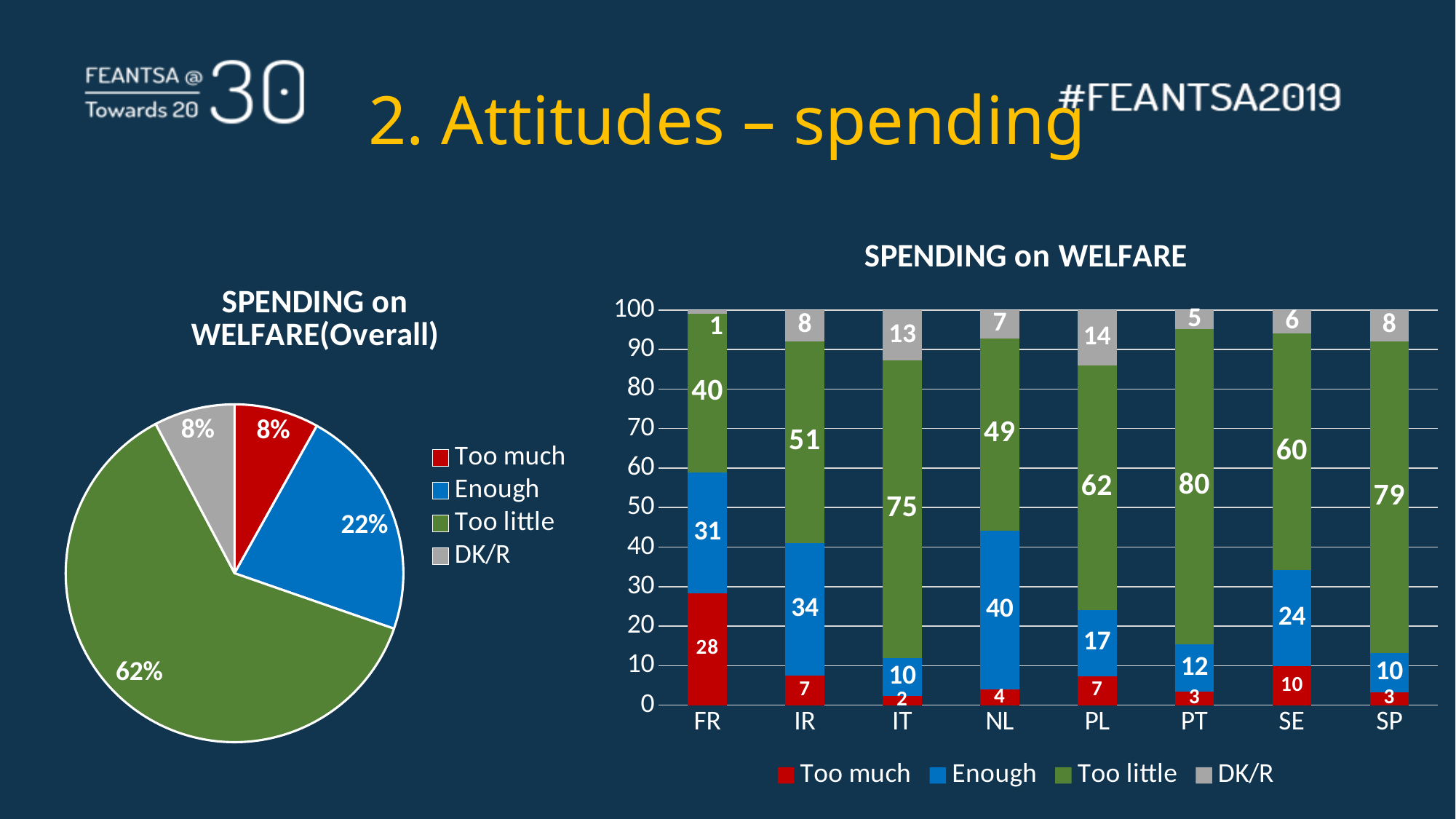
How many countries are shown on the x axis of the SPENDING on WELFARE bar chart? 8 In the SPENDING on WELFARE bar chart, what is the 'Too much' value for FR? 28 In the SPENDING on WELFARE bar chart, what is the 'Too little' value for PT? 80 In the SPENDING on WELFARE bar chart, is the 'Too little' value larger for SE or for PL? PL How many series does the legend of the SPENDING on WELFARE bar chart list? 4 In the SPENDING on WELFARE(Overall) pie chart, which category has the largest slice? Too little In the SPENDING on WELFARE bar chart, which country has the highest 'Too much' value? FR In the SPENDING on WELFARE bar chart, what is the difference between the 'Enough' values for NL and IT? 30 In the SPENDING on WELFARE(Overall) pie chart, what share of respondents said 'Too little'? 62% What type of chart is the SPENDING on WELFARE chart on the right of the slide? Stacked bar chart In the SPENDING on WELFARE(Overall) pie chart, what share of respondents said 'Enough'? 22% In the SPENDING on WELFARE bar chart, which country has the lowest 'DK/R' value? FR